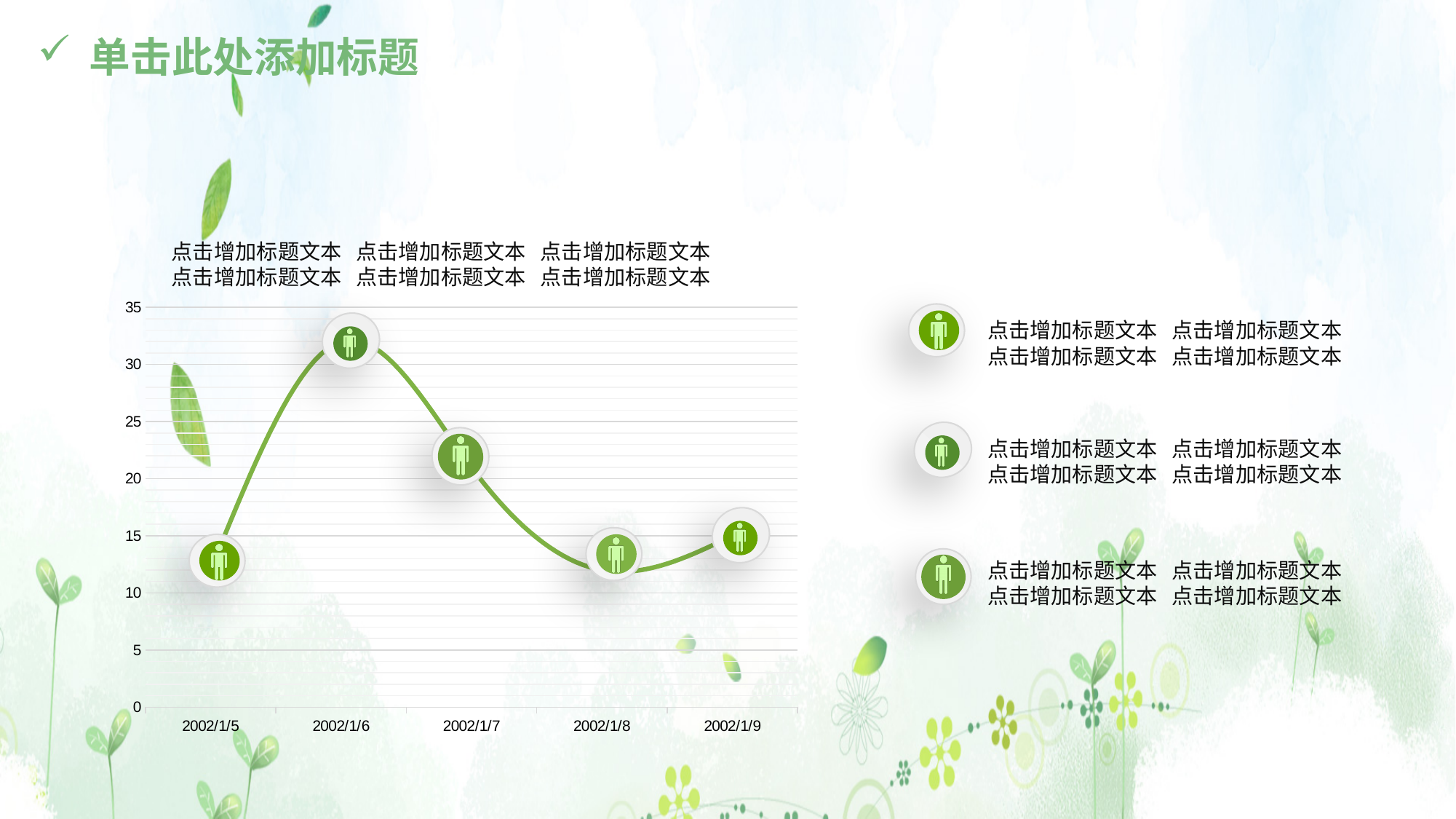
Which date has the highest value on the line chart? 2002/1/6 Which is larger, the value for 2002/1/6 or the value for 2002/1/7? 2002/1/6 Is the value for 2002/1/9 greater or less than 20? less Is the value for 2002/1/8 greater or less than 15? less How many data points are plotted on the line chart? 5 Is the value for 2002/1/5 greater or less than 10? greater Does the line rise or fall from 2002/1/6 to 2002/1/8? fall What is the highest tick value shown on the y axis of the chart? 35 Which is larger, the value for 2002/1/7 or the value for 2002/1/9? 2002/1/7 What kind of chart is shown on the slide? line chart